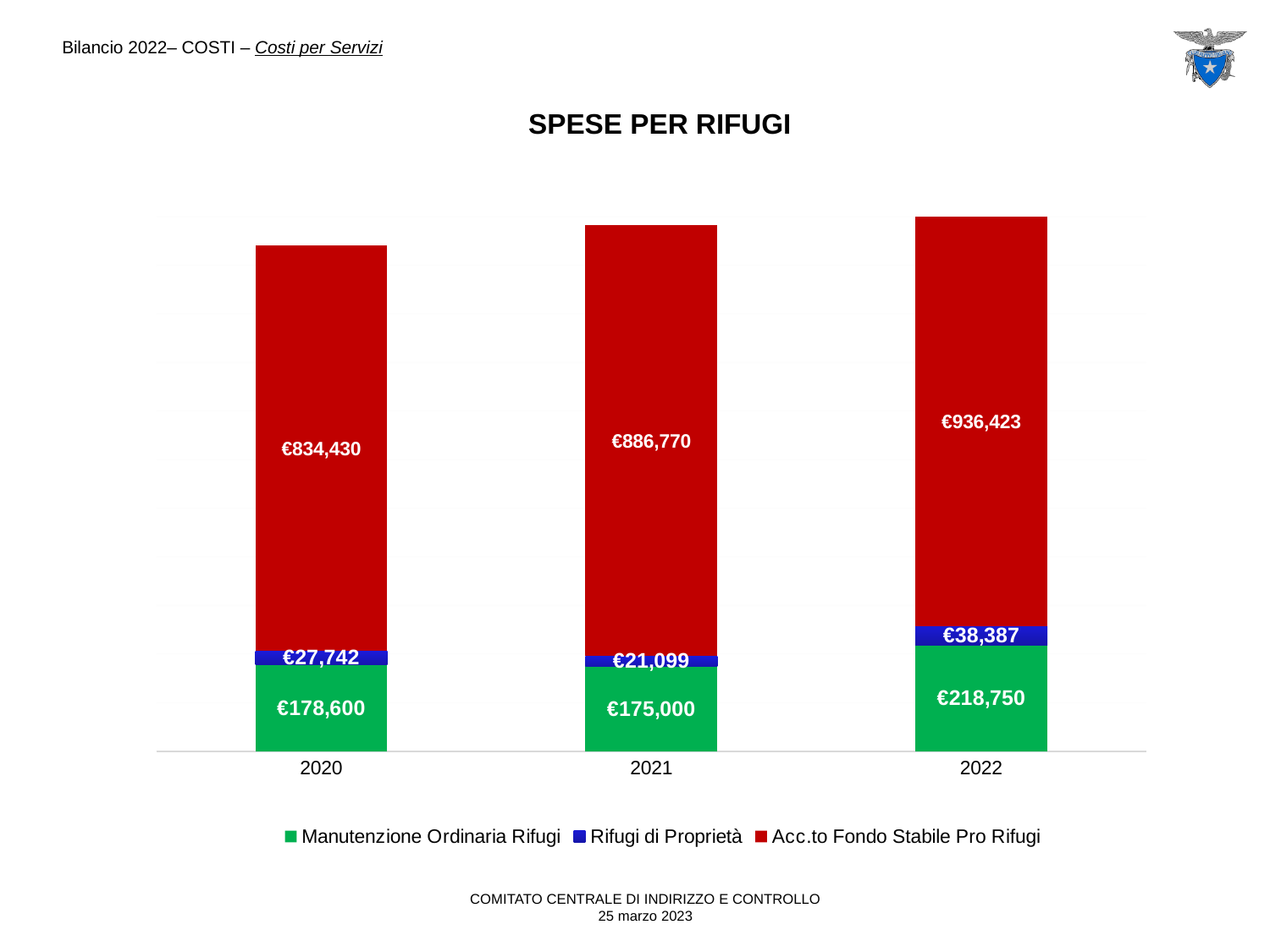
Which year has the lowest value for Rifugi di Proprietà? 2021 What is the value of Acc.to Fondo Stabile Pro Rifugi for 2022? €936,423 What is the total of the stacked bar for 2022? €1,193,560 Which year has the highest value for Acc.to Fondo Stabile Pro Rifugi? 2022 What is the value of Manutenzione Ordinaria Rifugi for 2021? €175,000 What is the difference between the Acc.to Fondo Stabile Pro Rifugi values for 2022 and 2021? €49,653 What is the total of the stacked bar for 2020? €1,040,772 What is the value of Rifugi di Proprietà for 2020? €27,742 How many years are shown on the x axis? 3 How many series does the legend list? 3 What is the difference between the Manutenzione Ordinaria Rifugi values for 2022 and 2020? €40,150 Which is larger, Manutenzione Ordinaria Rifugi in 2020 or in 2021? 2020